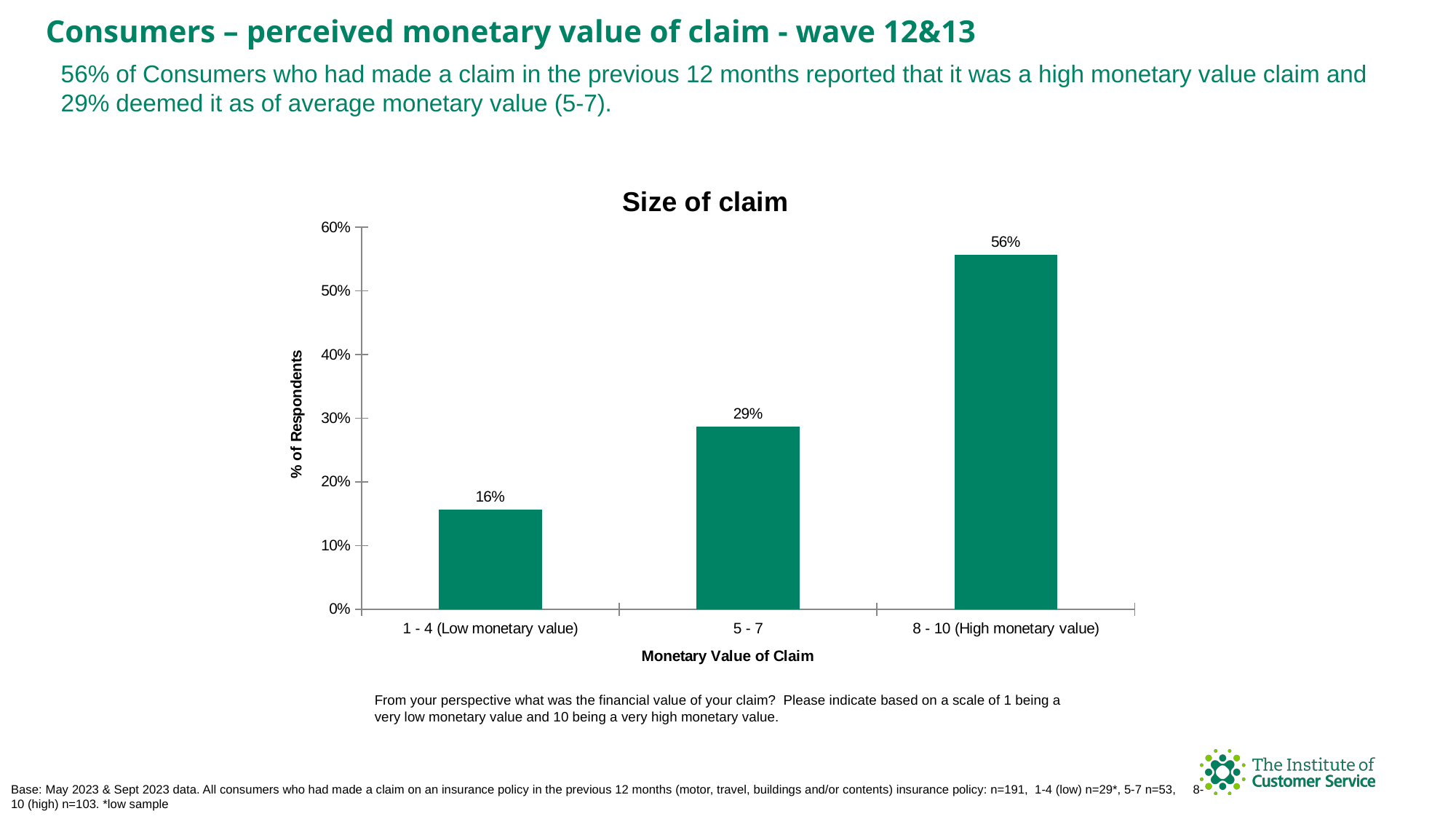
Which monetary value category has the highest percentage of respondents? 8 - 10 (High monetary value) Which monetary value category has the lowest percentage of respondents? 1 - 4 (Low monetary value) What is the difference in percentage points between the 5 - 7 and 1 - 4 (Low monetary value) categories? 13 Do the values rise or fall moving from the low monetary value category to the high monetary value category? Rise What type of chart is used to show the size of claim? Bar chart Is the value for 8 - 10 (High monetary value) greater or less than 50%? greater What percentage of respondents rated their claim as 1 - 4 (Low monetary value)? 16% What percentage of respondents rated their claim as 8 - 10 (High monetary value)? 56% How many monetary value categories are shown on the chart? 3 What percentage of respondents rated their claim as 5 - 7? 29% Which has a larger share of respondents: 5 - 7 or 1 - 4 (Low monetary value)? 5 - 7 What is the difference in percentage points between the 8 - 10 (High monetary value) and 5 - 7 categories? 27